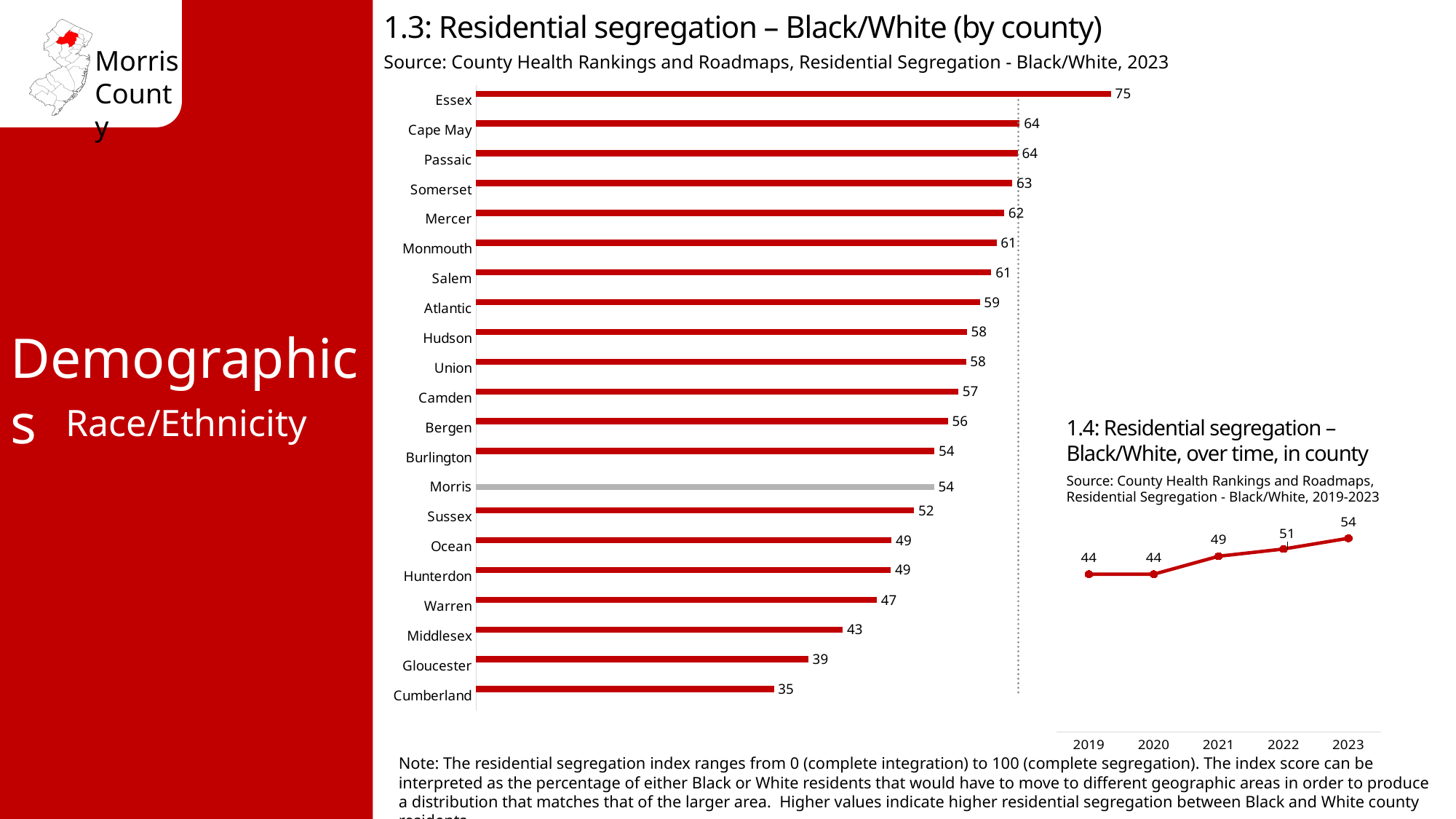
In chart 1.3 (by county), which has a larger value, Middlesex or Gloucester? Middlesex In chart 1.4 (Residential segregation – Black/White over time), what is the value for 2021? 49 What kind of chart is chart 1.3 (Residential segregation – Black/White by county)? Bar chart In chart 1.4 (over time), what is the difference between the 2023 and 2019 values? 10 In chart 1.3 (by county), what is the difference between the values for Essex and Cumberland? 40 In chart 1.3 (by county), what is the value for Essex? 75 In chart 1.3 (by county), which county has the lowest value? Cumberland In chart 1.4 (over time), do the values rise or fall from 2019 to 2023? Rise In chart 1.3 (by county), how many counties are shown? 21 In chart 1.3 (Residential segregation – Black/White by county), what is the value for Morris? 54 In chart 1.3 (by county), which county has the highest value? Essex In chart 1.3 (by county), which bar is shown in grey instead of red? Morris